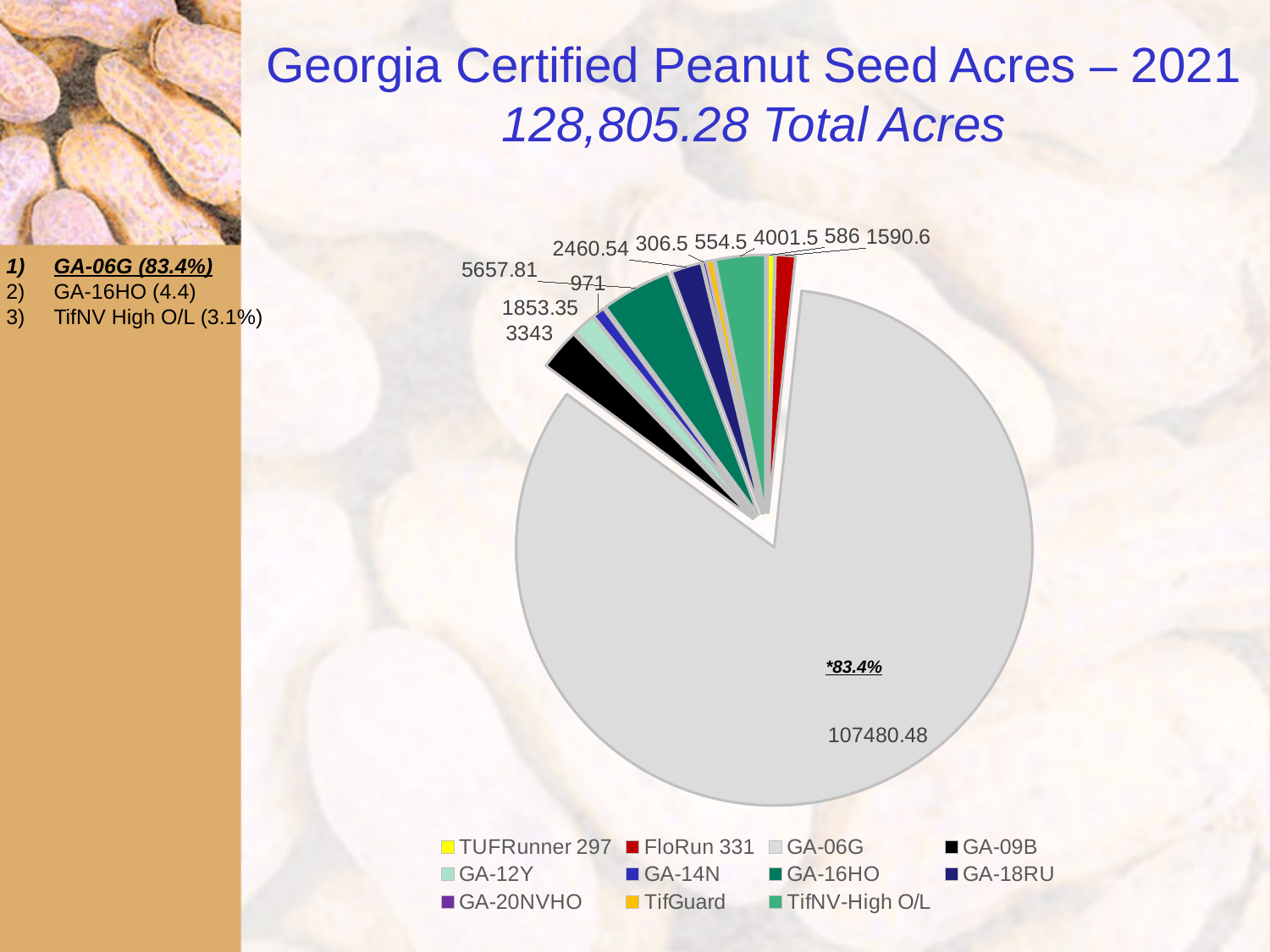
What is the value shown for GA-16HO in the pie chart? 5657.81 What share of the pie does GA-06G represent, as labelled on the slide? 83.4% What is the difference between the values for GA-16HO and TifNV-High O/L? 1656.31 What is the value shown for FloRun 331 in the pie chart? 1590.6 Which is larger, the value for GA-09B or the value for GA-18RU? GA-09B Which variety has the largest slice of the pie chart? GA-06G How many varieties (categories) does the pie chart legend list? 11 What is the value shown for GA-06G in the pie chart? 107480.48 What is the value shown for GA-09B in the pie chart? 3343 What type of chart is shown on the slide? Pie chart What is the value shown for TifNV-High O/L in the pie chart? 4001.5 Which variety has the smallest slice of the pie chart? GA-20NVHO